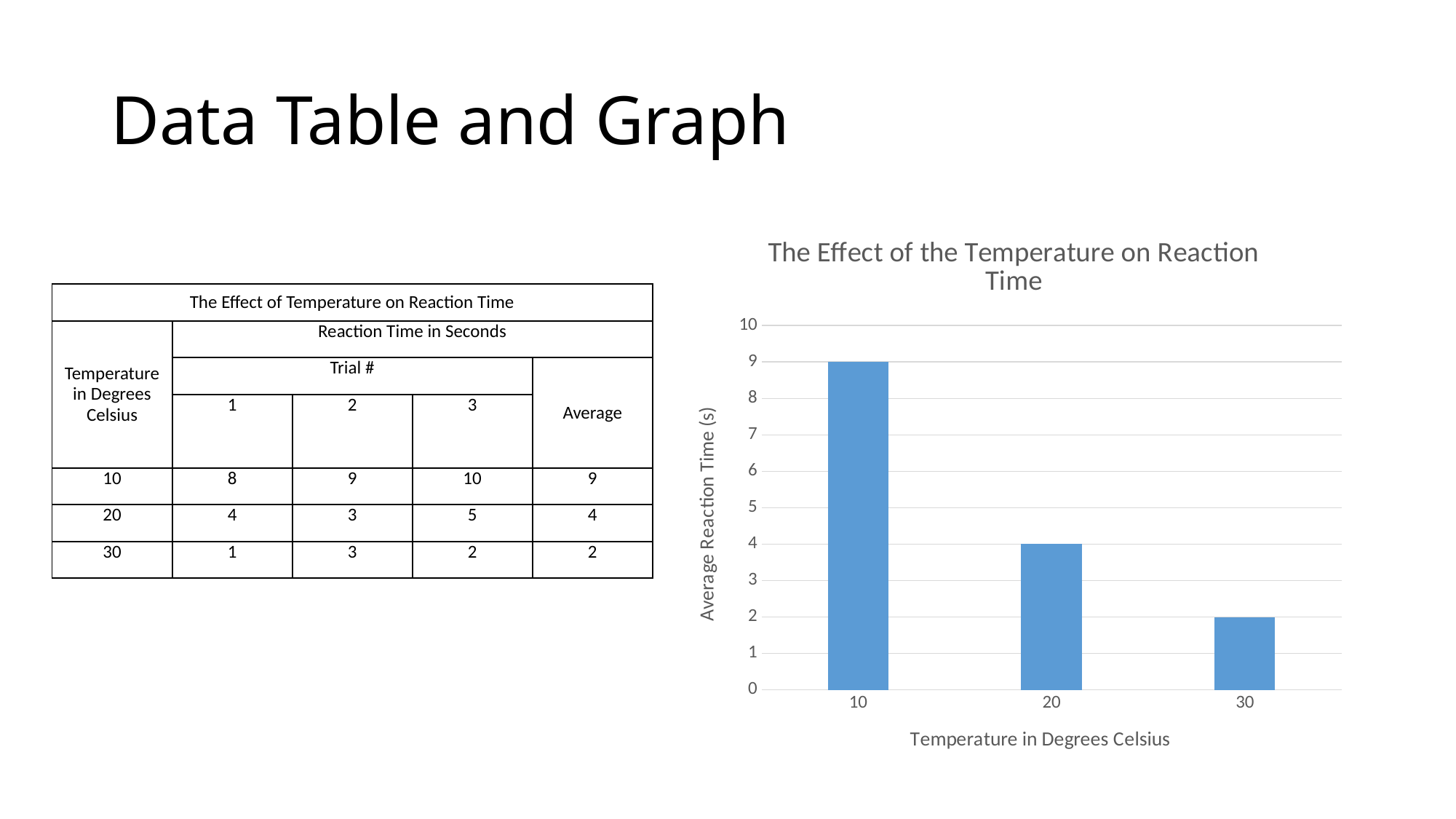
Which temperature has the highest average reaction time? 10 What is the average reaction time for 30 degrees Celsius? 2 Is the average reaction time for 10 degrees greater or less than 5? greater Which has a larger average reaction time, 20 degrees or 30 degrees? 20 What is the average reaction time for 20 degrees Celsius? 4 How many temperature categories are shown on the chart? 3 What is the difference between the average reaction time at 10 degrees and at 30 degrees? 7 Do the average reaction times rise or fall as temperature increases along the x axis? fall What kind of chart is shown on the slide? bar chart What is the title of the chart? The Effect of the Temperature on Reaction Time What is the average reaction time for 10 degrees Celsius? 9 Which temperature has the lowest average reaction time? 30